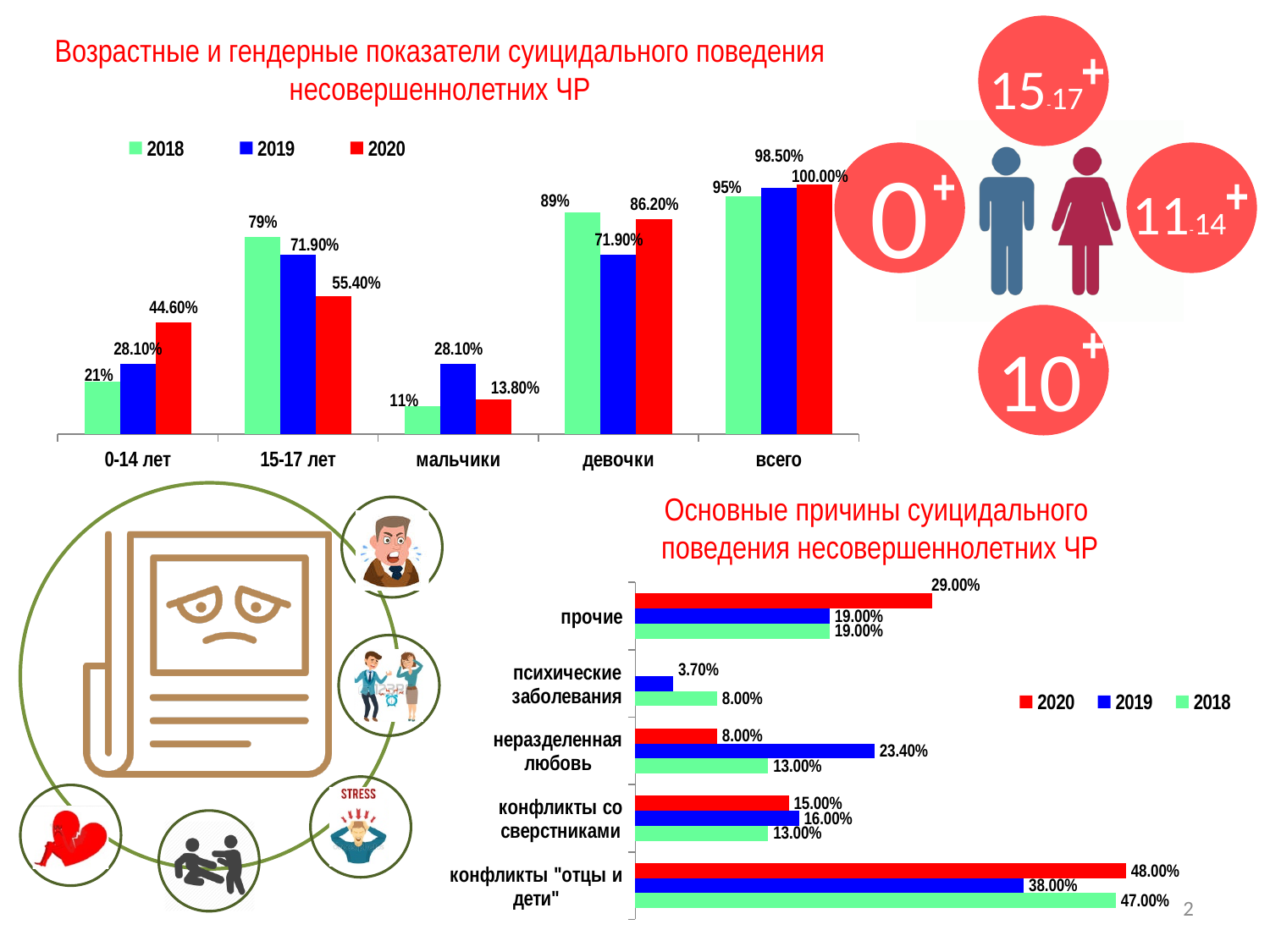
In the chart 'Возрастные и гендерные показатели суицидального поведения несовершеннолетних ЧР', what is the difference between the 2018 and 2020 values for 15-17 лет? 23.60% In the chart 'Основные причины суицидального поведения несовершеннолетних ЧР', what is the value for конфликты "отцы и дети" in 2020? 48.00% In the chart 'Возрастные и гендерные показатели суицидального поведения несовершеннолетних ЧР', how many series does the legend list? 3 What kind of chart is 'Основные причины суицидального поведения несовершеннолетних ЧР'? Bar chart In the chart 'Возрастные и гендерные показатели суицидального поведения несовершеннолетних ЧР', which category has the highest value for 2018? всего In the chart 'Основные причины суицидального поведения несовершеннолетних ЧР', which is larger for прочие: the 2020 value or the 2019 value? 2020 In the chart 'Возрастные и гендерные показатели суицидального поведения несовершеннолетних ЧР', what is the value for мальчики in 2019? 28.10% In the chart 'Основные причины суицидального поведения несовершеннолетних ЧР', what is the difference between the 2018 and 2019 values for психические заболевания? 4.30% In the chart 'Возрастные и гендерные показатели суицидального поведения несовершеннолетних ЧР', which category has the lowest value for 2020? мальчики In the chart 'Основные причины суицидального поведения несовершеннолетних ЧР', what is the value for неразделенная любовь in 2019? 23.40% In the chart 'Возрастные и гендерные показатели суицидального поведения несовершеннолетних ЧР', what is the value for 0-14 лет in 2020? 44.60% In the chart 'Возрастные и гендерные показатели суицидального поведения несовершеннолетних ЧР', how many categories are shown on the x axis? 5